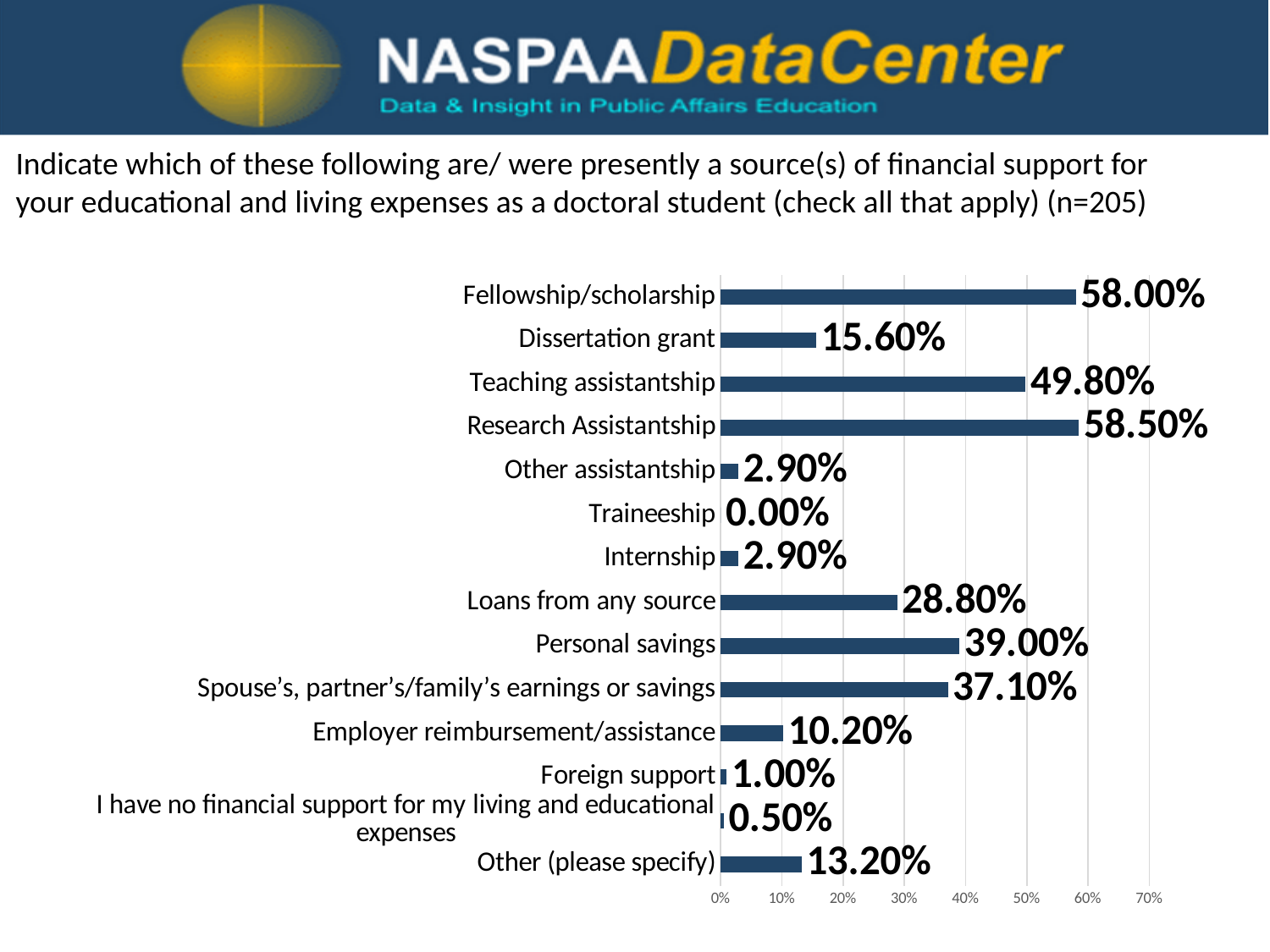
What is the value shown for Loans from any source? 28.80% Which source of financial support has the lowest value in the chart? Traineeship Which source of financial support has the highest value in the chart? Research Assistantship What kind of chart is shown on the slide? Bar chart Which is larger, the value for Personal savings or the value for Spouse's, partner's/family's earnings or savings? Personal savings Is the value for Teaching assistantship greater or less than 40%? greater What percentage of respondents reported Fellowship/scholarship as a source of financial support? 58.00% What is the sample size (n) stated in the chart's title? 205 What is the difference between the values for Research Assistantship and Fellowship/scholarship? 0.50% What percentage is shown for Employer reimbursement/assistance? 10.20% How many categories are shown in the chart? 14 What is the difference between the values for Teaching assistantship and Dissertation grant? 34.20%